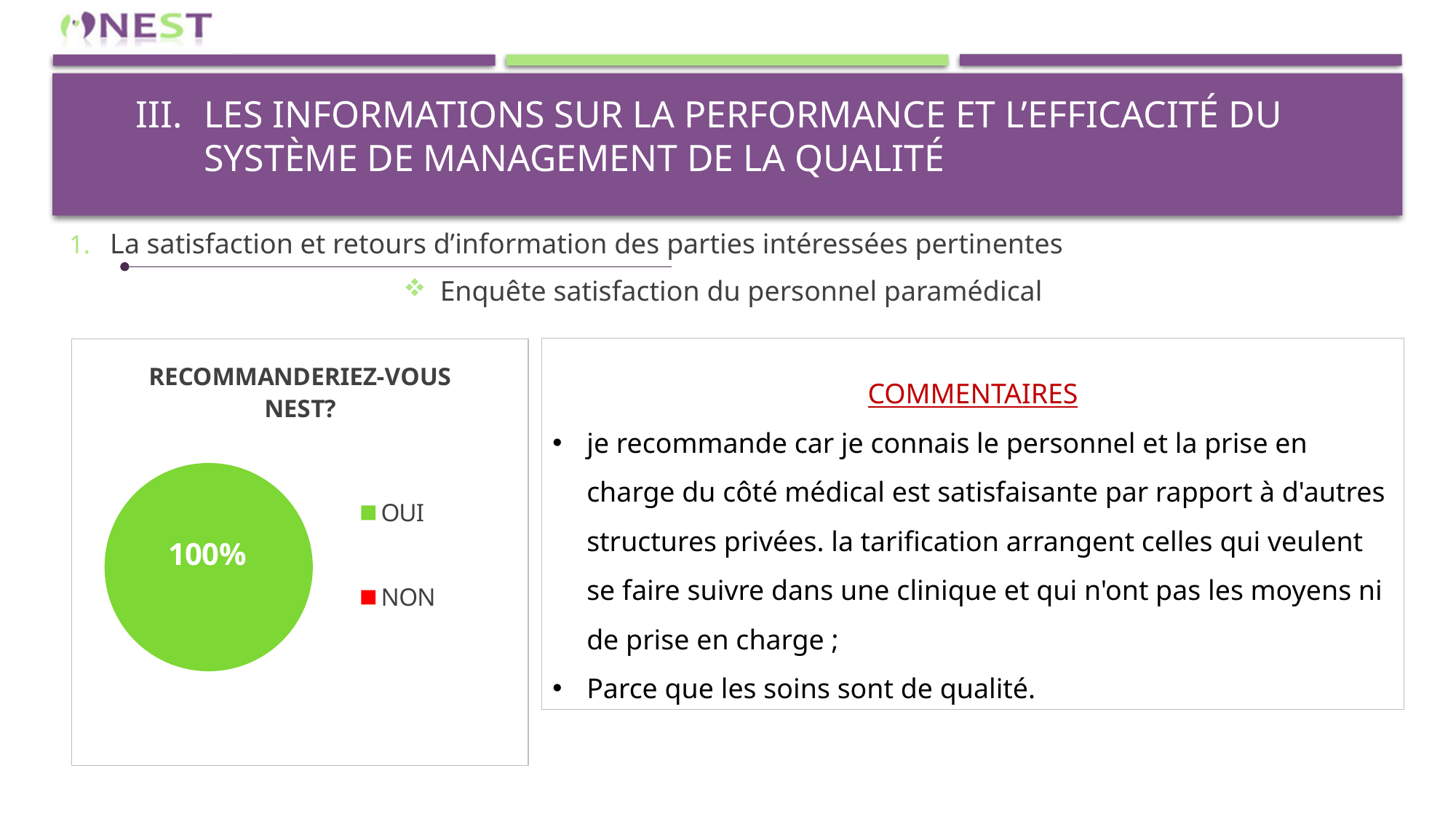
What is the title of the pie chart on the slide? RECOMMANDERIEZ-VOUS NEST? What colour represents OUI in the pie chart legend? green Which is larger in the pie chart, OUI or NON? OUI Which category has the largest share in the pie chart? OUI What share of the pie chart does the OUI slice take? 100% What is the data label printed on the pie chart? 100% Which category has the smallest share in the pie chart? NON What kind of chart is shown under the title "RECOMMANDERIEZ-VOUS NEST?"? pie chart How many entries does the legend of the pie chart list? 2